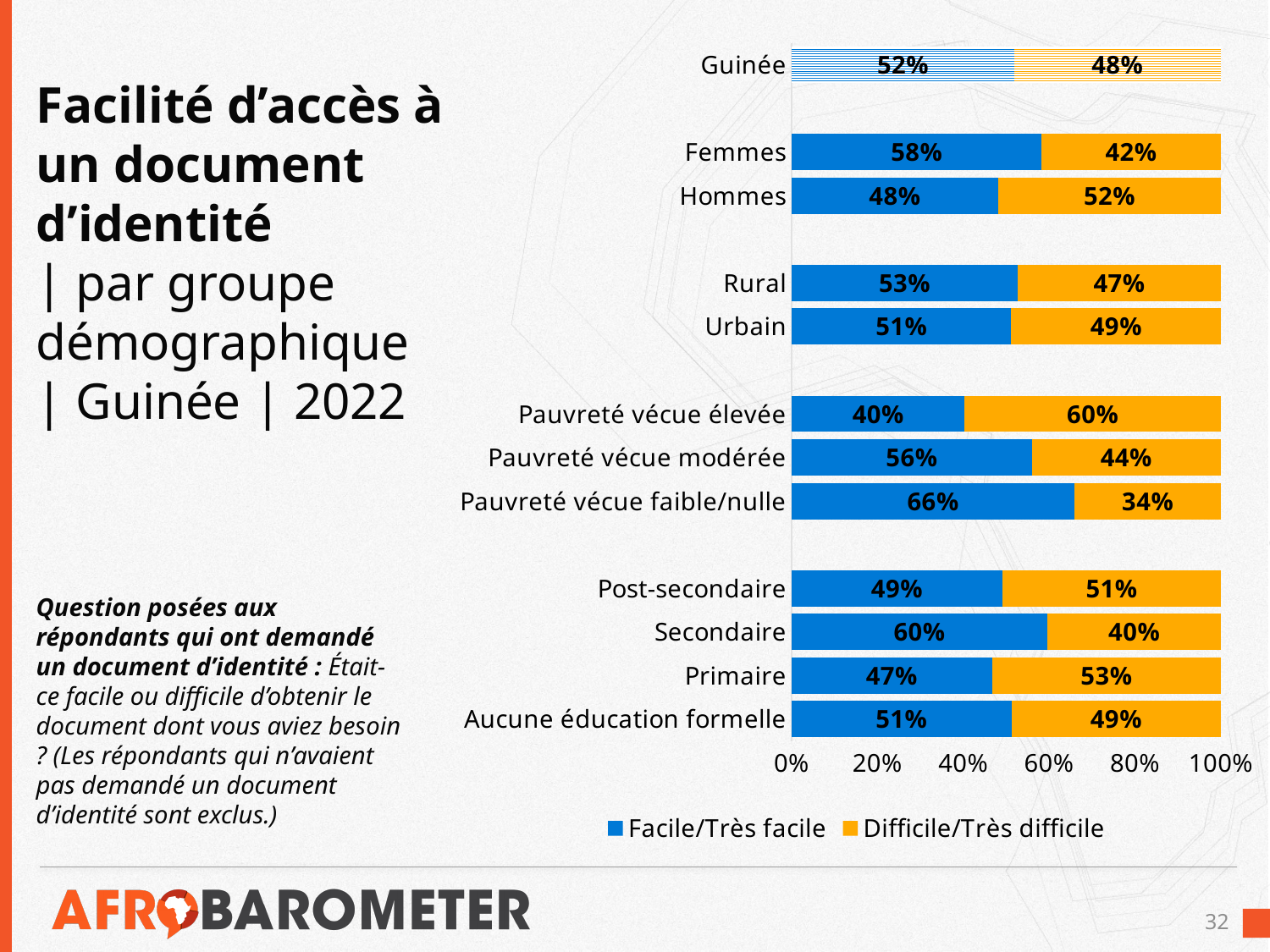
What is the Facile/Très facile value for Guinée overall? 52% What is the Difficile/Très difficile value for Pauvreté vécue élevée? 60% How many series does the legend list? 2 What is the Facile/Très facile value for Femmes? 58% What is the difference between the Facile/Très facile values for Secondaire and Primaire? 13 percentage points How many categories are shown on the chart? 13 What kind of chart is shown on the slide? Stacked bar chart Which category has the lowest Facile/Très facile value? Pauvreté vécue élevée Which category has the highest Facile/Très facile value? Pauvreté vécue faible/nulle What colour represents Difficile/Très difficile in the chart? Orange Is the Facile/Très facile value for Hommes greater or less than 60%? less Which has a larger Facile/Très facile value, Rural or Urbain? Rural